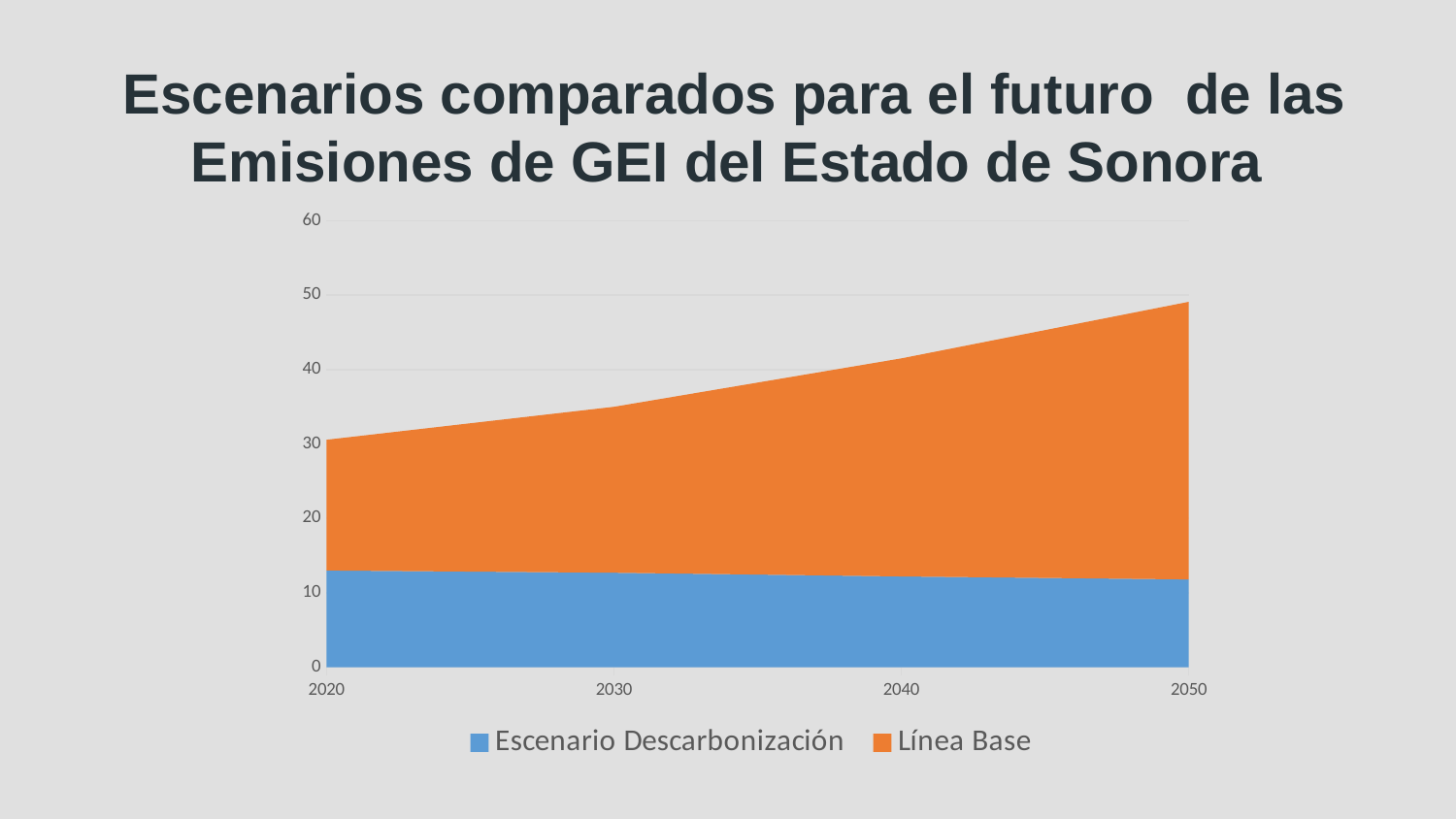
Is the value for Escenario Descarbonización in 2020 greater or less than 10? greater Is the top of the Línea Base area in 2020 greater or less than 20? greater Is the top of the Línea Base area in 2040 greater or less than 50? less Does the Escenario Descarbonización series rise or fall from 2020 to 2050? Falls What kind of chart is shown on the slide? Area chart Does the Línea Base series rise or fall from 2020 to 2050? Rises What colour represents the Escenario Descarbonización series? Blue Which series reaches a higher level in 2050, Escenario Descarbonización or Línea Base? Línea Base How many series does the legend list? 2 How many year labels are shown on the x axis? 4